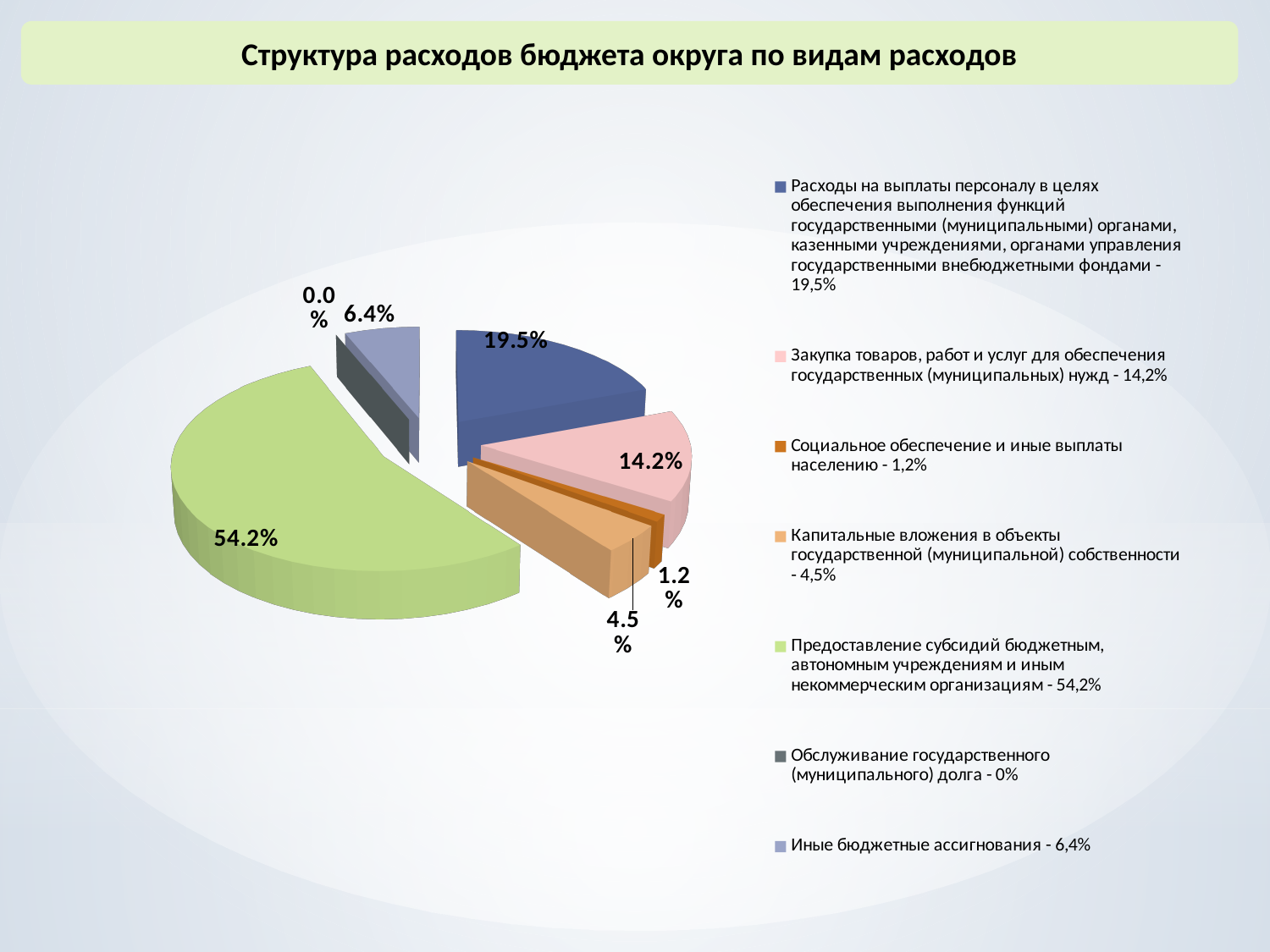
What share of the pie is labelled for 'Капитальные вложения в объекты государственной (муниципальной) собственности'? 4.5% Which category has the largest slice of the pie? Предоставление субсидий бюджетным, автономным учреждениям и иным некоммерческим организациям What kind of chart is shown on the slide? pie chart Which category has the smallest slice of the pie? Обслуживание государственного (муниципального) долга What is the chart's title? Структура расходов бюджета округа по видам расходов What share of the pie is labelled for 'Иные бюджетные ассигнования'? 6.4% How many entries does the legend list? 7 What colour is the slice for 'Предоставление субсидий бюджетным, автономным учреждениям и иным некоммерческим организациям'? green What share of the pie is labelled for 'Закупка товаров, работ и услуг для обеспечения государственных (муниципальных) нужд'? 14.2% What is the difference between the share for 'Расходы на выплаты персоналу...' (19.5%) and the share for 'Закупка товаров, работ и услуг...' (14.2%)? 5.3% Which is larger: the share for 'Иные бюджетные ассигнования' or the share for 'Капитальные вложения в объекты государственной (муниципальной) собственности'? Иные бюджетные ассигнования What share of the pie is labelled for 'Предоставление субсидий бюджетным, автономным учреждениям и иным некоммерческим организациям'? 54.2%